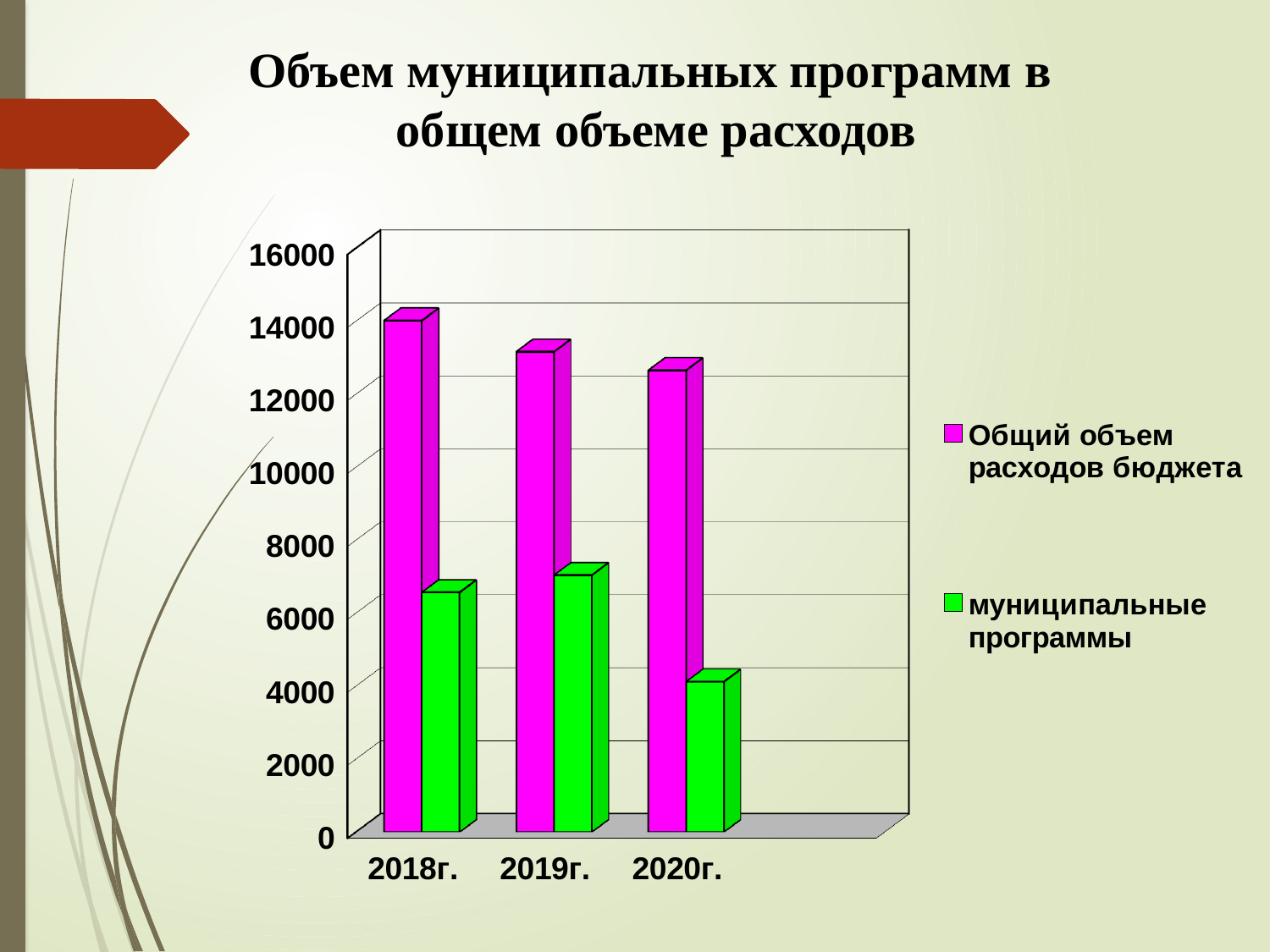
Is the value for "Общий объем расходов бюджета" in 2018г. greater or less than 12000? greater Does the value for "Общий объем расходов бюджета" rise or fall from 2018г. to 2020г.? fall What kind of chart is shown on the slide? bar chart Which is larger: "Общий объем расходов бюджета" in 2018г. or in 2020г.? 2018г. What colour are the bars for "муниципальные программы"? green In which year is the value for "Общий объем расходов бюджета" highest? 2018г. In which year is the value for "муниципальные программы" lowest? 2020г. Is the value for "муниципальные программы" in 2020г. greater or less than 6000? less Is the value for "Общий объем расходов бюджета" in 2020г. greater or less than 10000? greater How many years are shown on the x axis? 3 How many series does the legend list? 2